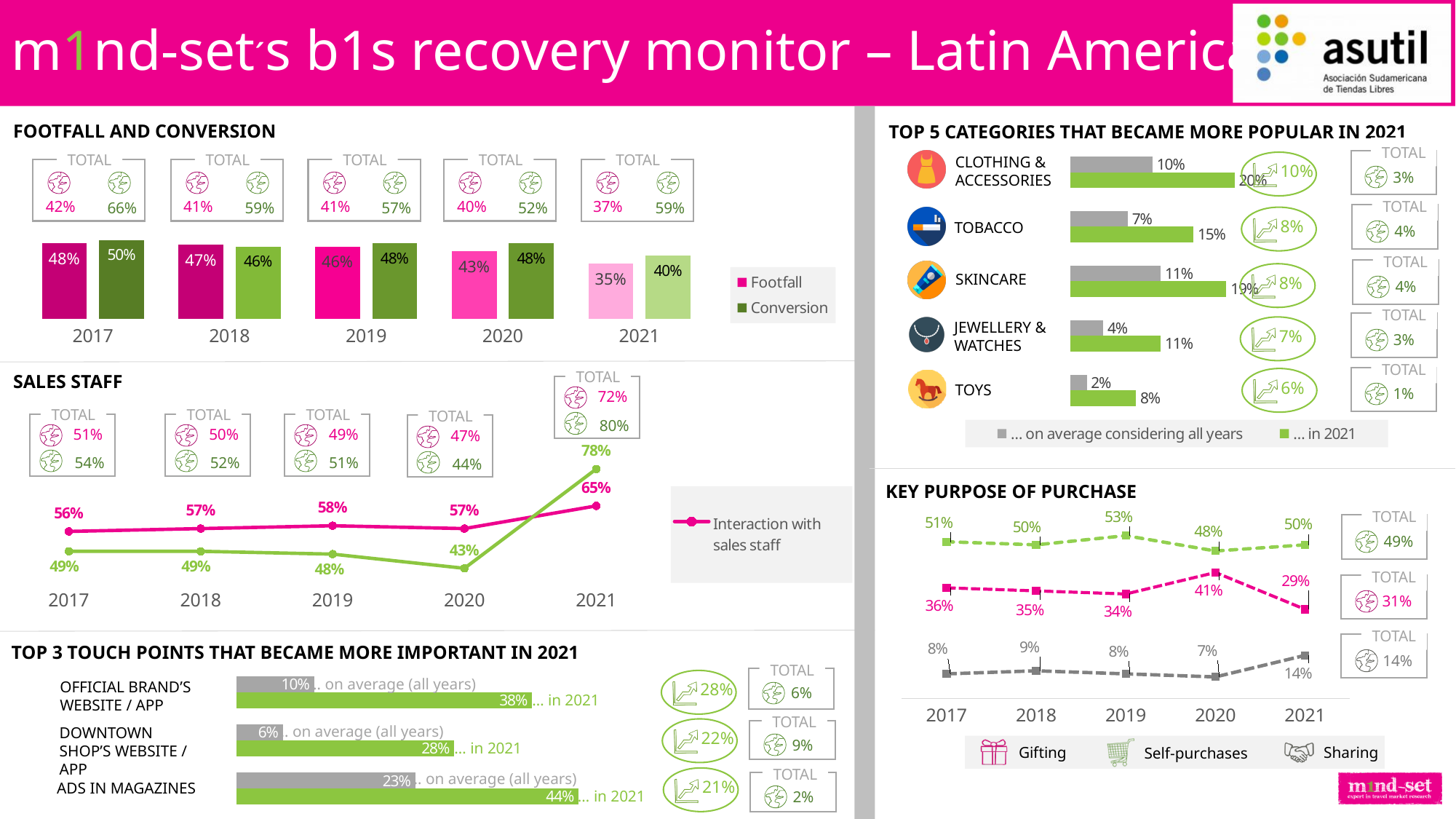
In the Sales Staff chart, what kind of chart is shown? Line chart In the Top 5 Categories chart, what is the 2021 value for Tobacco? 15% In the Footfall and Conversion chart, which year has the lowest Footfall value? 2021 In the Footfall and Conversion chart, how many series does the legend list? 2 In the Top 5 Categories chart, which category has the lowest average value considering all years? Toys In the Top 3 Touch Points chart, what is the 2021 value for Ads in Magazines? 44% In the Key Purpose of Purchase chart, what is the Self-purchases value for 2020? 48% In the Sales Staff chart, what is the value of the pink line in 2019? 58% In the Footfall and Conversion chart, what is the Conversion value for 2017? 50% In the Sales Staff chart, what is the value of the green line in 2021? 78% In the Footfall and Conversion chart, what is the Footfall value for 2021? 35% In the Footfall and Conversion chart, what is the difference between Conversion and Footfall in 2020? 5%